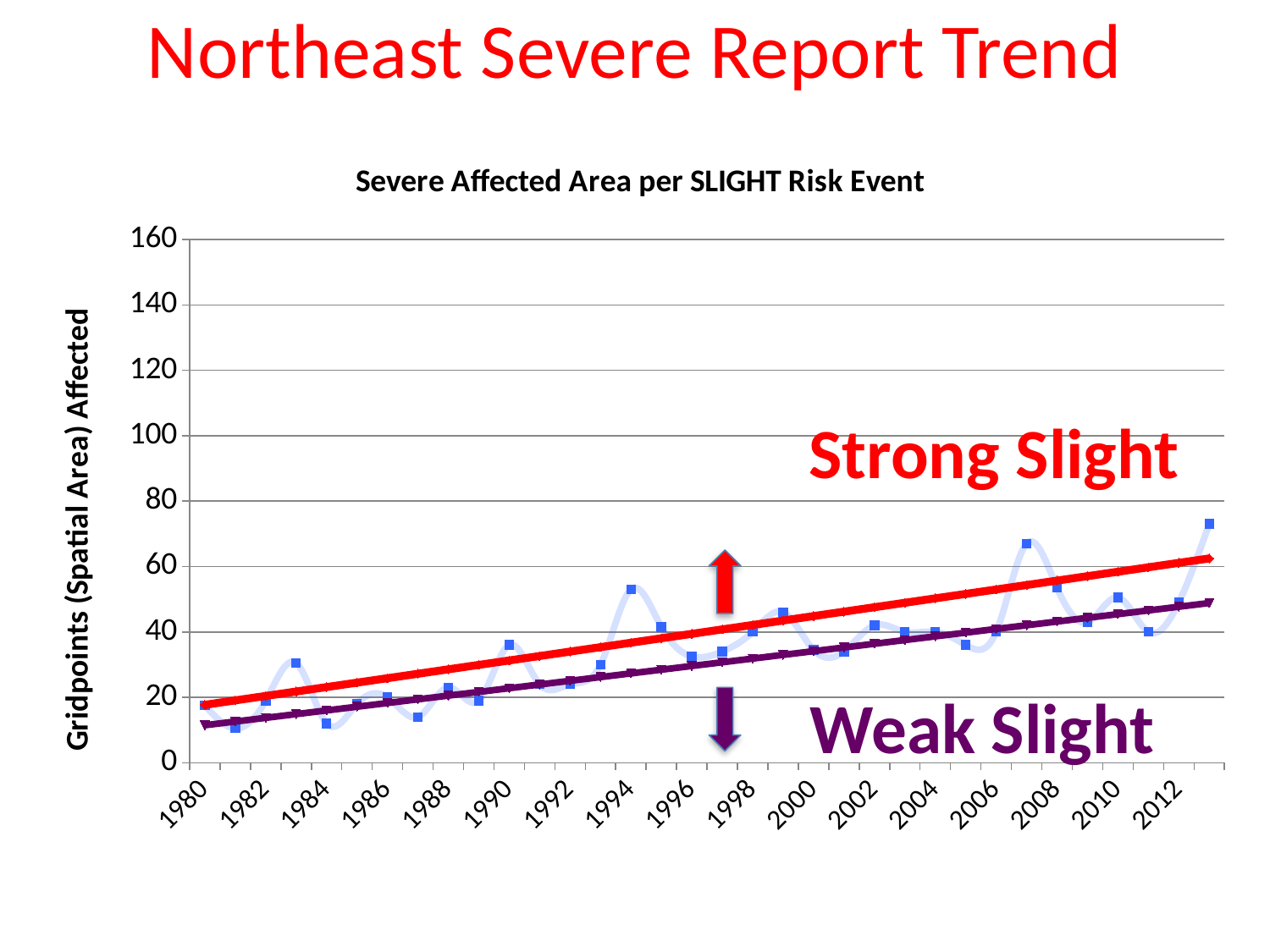
What is the label on the vertical axis of the chart? Gridpoints (Spatial Area) Affected What is the title of the chart? Severe Affected Area per SLIGHT Risk Event Is the plotted value for 2007 greater or less than 60? greater Is the plotted value for 1987 greater or less than 20? less Which trend line sits higher on the chart, Strong Slight or Weak Slight? Strong Slight Is the plotted value for 1981 greater or less than 20? less What is the highest value shown on the vertical axis? 160 Which year has the larger plotted value, 1994 or 1996? 1994 Does the Strong Slight trend line rise or fall from 1980 to 2012? rise What kind of chart is shown on the slide? line chart Which year has the highest plotted value on the chart? 2013